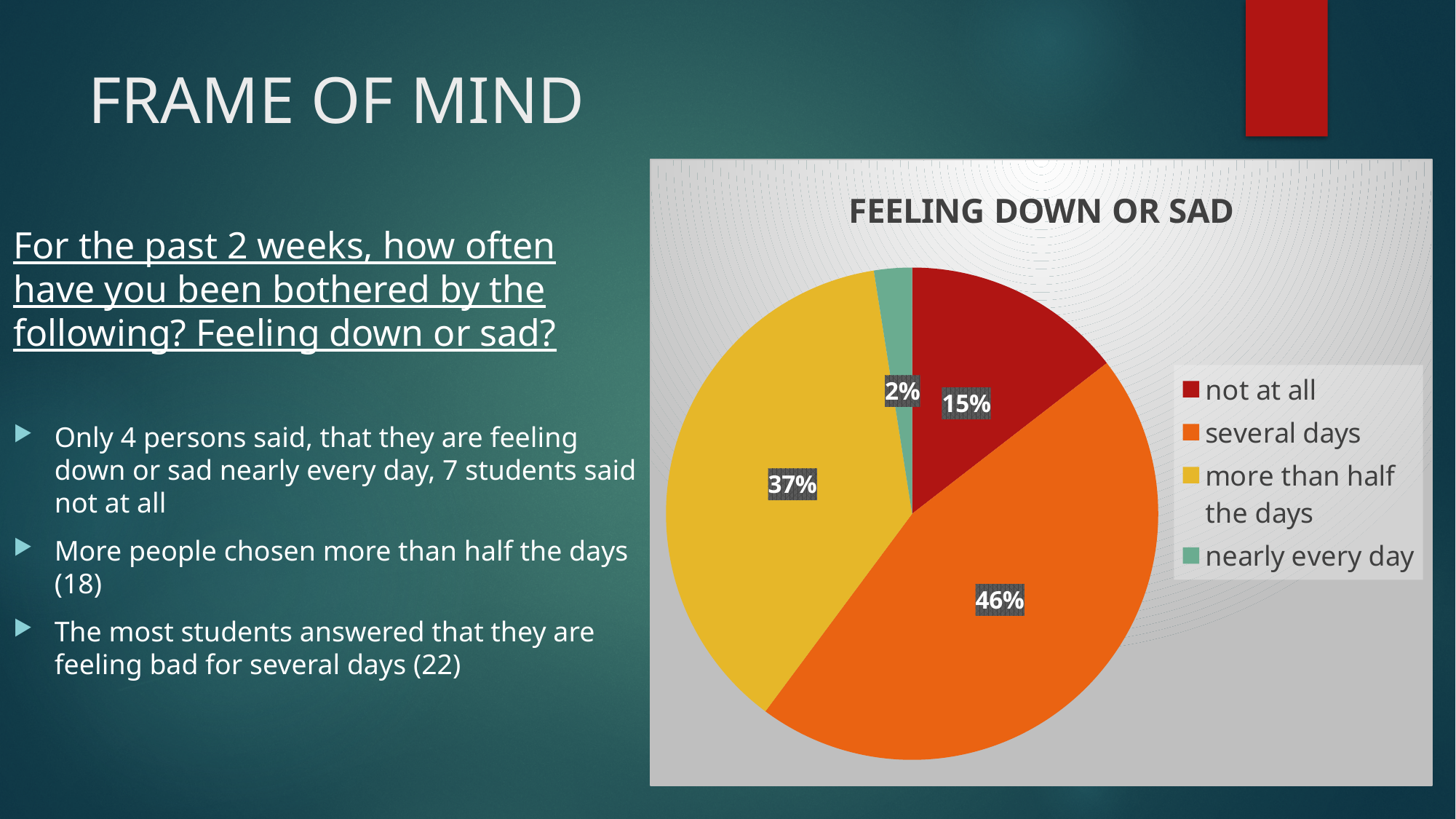
What percentage of the pie is labelled 'nearly every day'? 2% What colour represents 'nearly every day' in the chart? green What is the difference in percentage points between 'several days' and 'more than half the days'? 9 What percentage of the pie is labelled 'more than half the days'? 37% What percentage of the pie is labelled 'several days'? 46% What percentage of the pie is labelled 'not at all'? 15% How many categories does the legend list? 4 What type of chart is shown on the slide? pie chart Which category has the largest share of the pie? several days What is the title of the chart? FEELING DOWN OR SAD Which category has the smallest share of the pie? nearly every day Which is larger, the share for 'not at all' or the share for 'more than half the days'? more than half the days